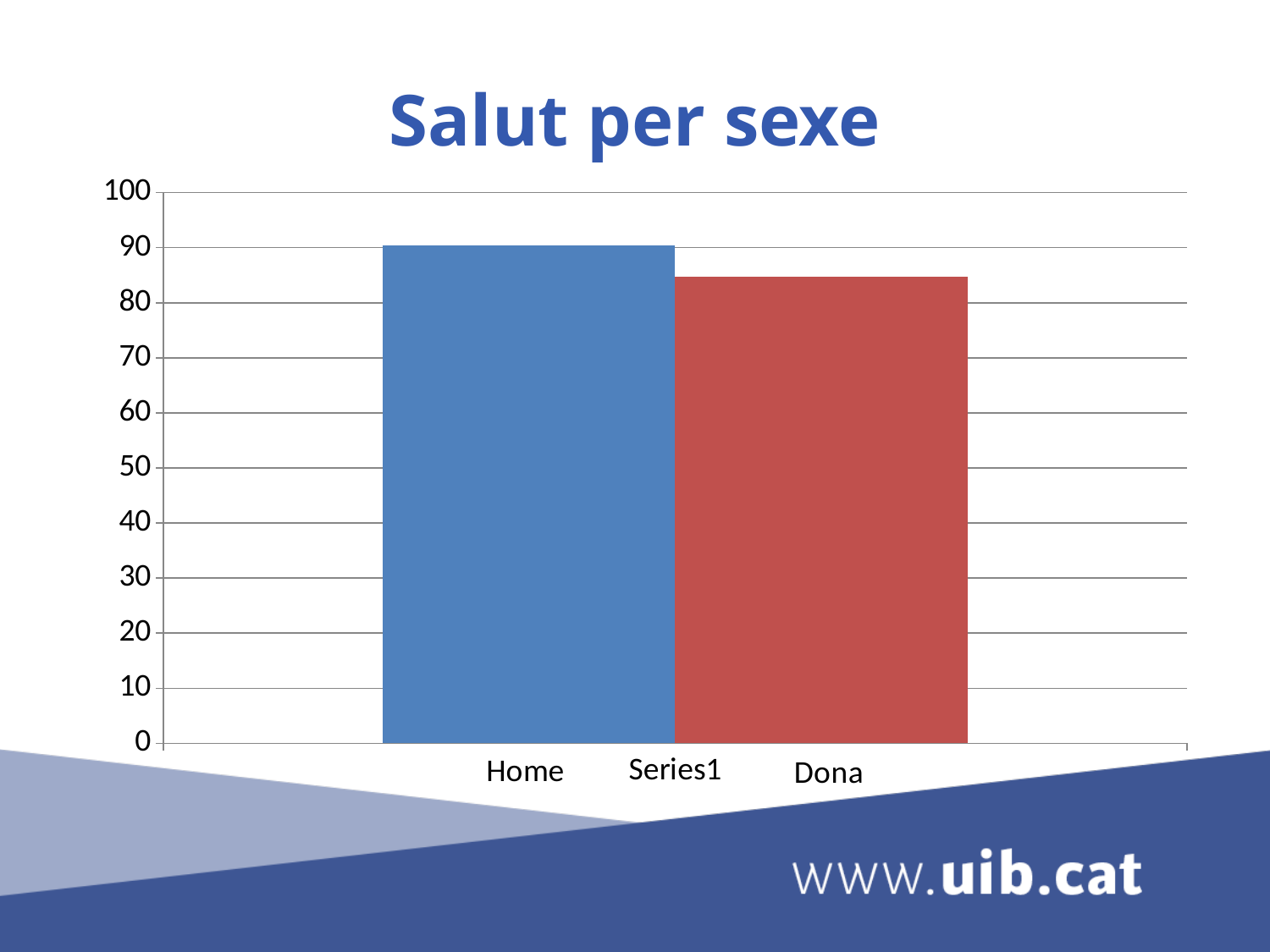
What kind of chart is shown on the slide? bar chart How many bars are plotted in the chart? 2 Is the value for Dona greater or less than 80? greater Which category has the lowest bar? Dona Which is larger, the value for Home or the value for Dona? Home Which category has the highest bar? Home What is the highest value shown on the vertical axis? 100 What is the title of the chart? Salut per sexe Is the value for Home greater or less than 80? greater Is the value for Home greater or less than 100? less What colour is the bar for Dona? red